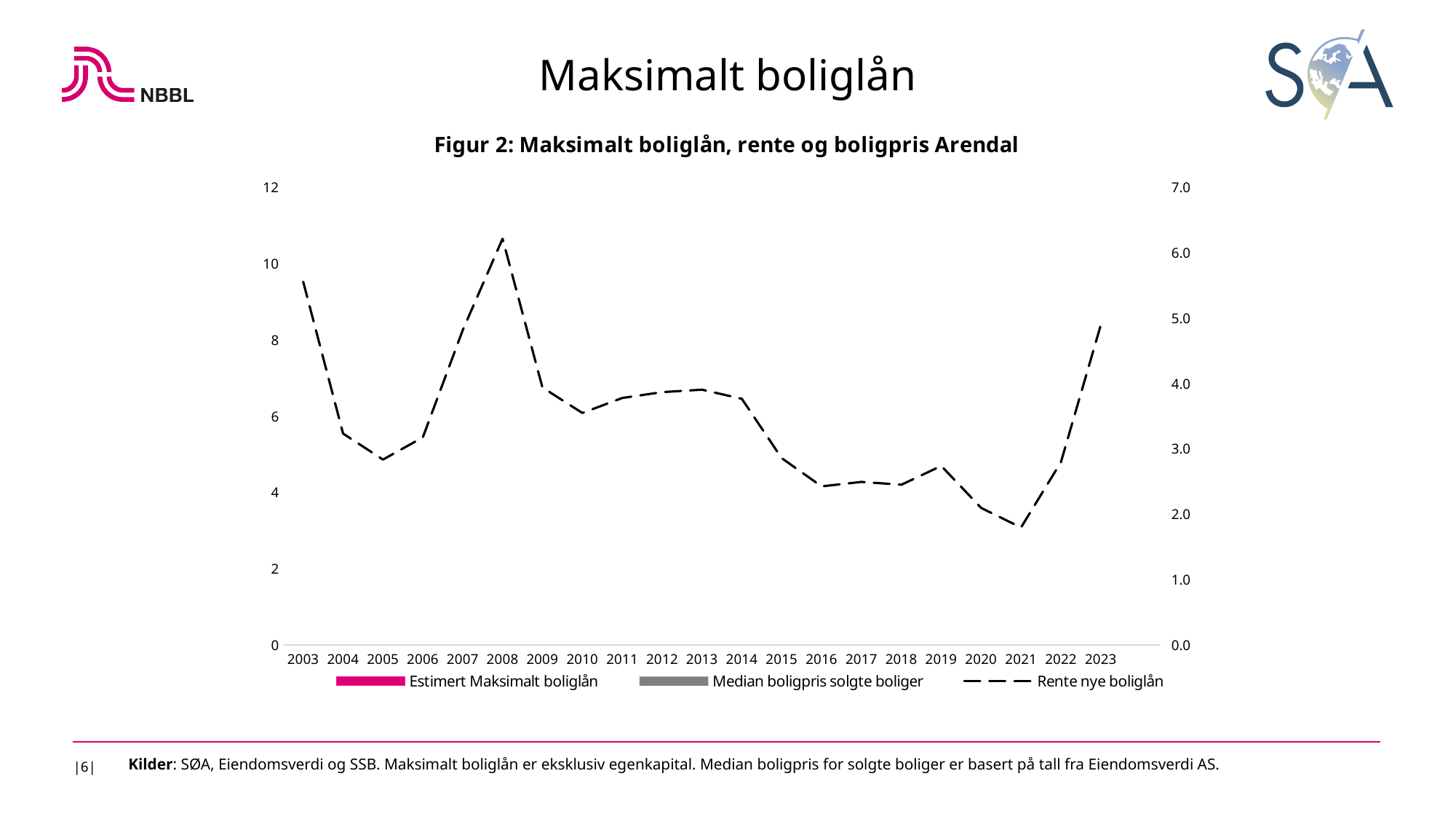
Is the value of Rente nye boliglån in 2003 greater or less than 5.0 on the right axis? greater Is the value of Rente nye boliglån in 2008 greater or less than 6.0 on the right axis? greater Does the Rente nye boliglån line rise or fall from 2021 to 2023? rise Is the value of Rente nye boliglån in 2021 greater or less than 2.0 on the right axis? less How many series does the legend of Figur 2 list? 3 Which series in Figur 2 is drawn as a dashed line? Rente nye boliglån In which year does the Rente nye boliglån line reach its lowest value? 2021 How many years are shown on the x axis of Figur 2? 21 In which year does the Rente nye boliglån line reach its highest value? 2008 Which year has the higher Rente nye boliglån value, 2008 or 2003? 2008 What kind of chart is shown in Figur 2? line chart